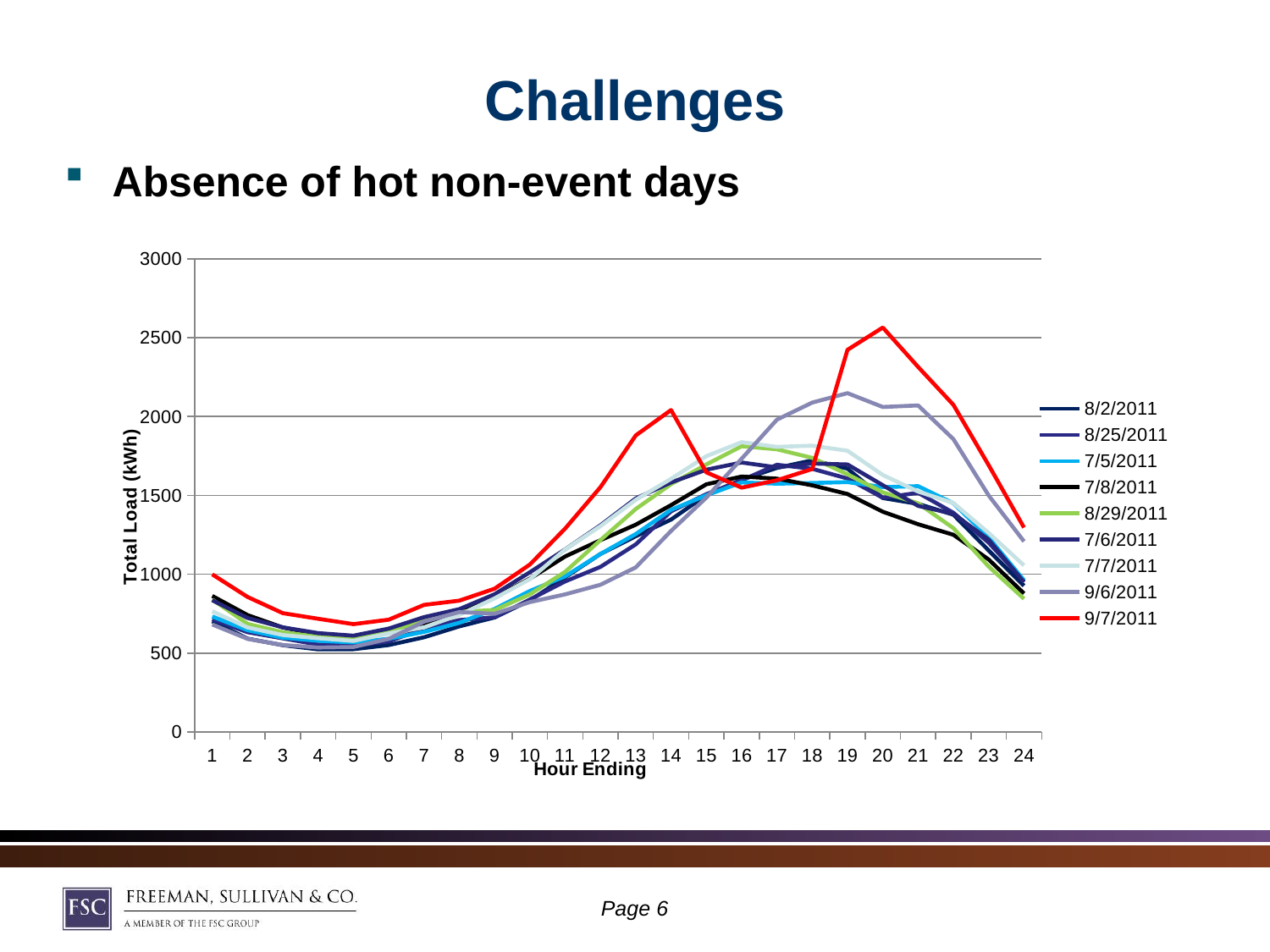
Is the value for 9/7/2011 at hour ending 20 greater or less than 2000? greater Which series reaches the highest total load on the chart? 9/7/2011 Is the value for 9/7/2011 at hour ending 14 greater or less than 1500? greater What is the label of the y axis? Total Load (kWh) How many series does the legend list? 9 Do the values for 9/7/2011 rise or fall from hour ending 1 to hour ending 5? fall At hour ending 20, which series has the larger value, 9/7/2011 or 7/8/2011? 9/7/2011 How many hour-ending points are plotted along the x axis? 24 Is the value for 9/6/2011 at hour ending 19 greater or less than 2000? greater What kind of chart is shown on the slide? line chart At hour ending 13, which series has the larger value, 9/6/2011 or 9/7/2011? 9/7/2011